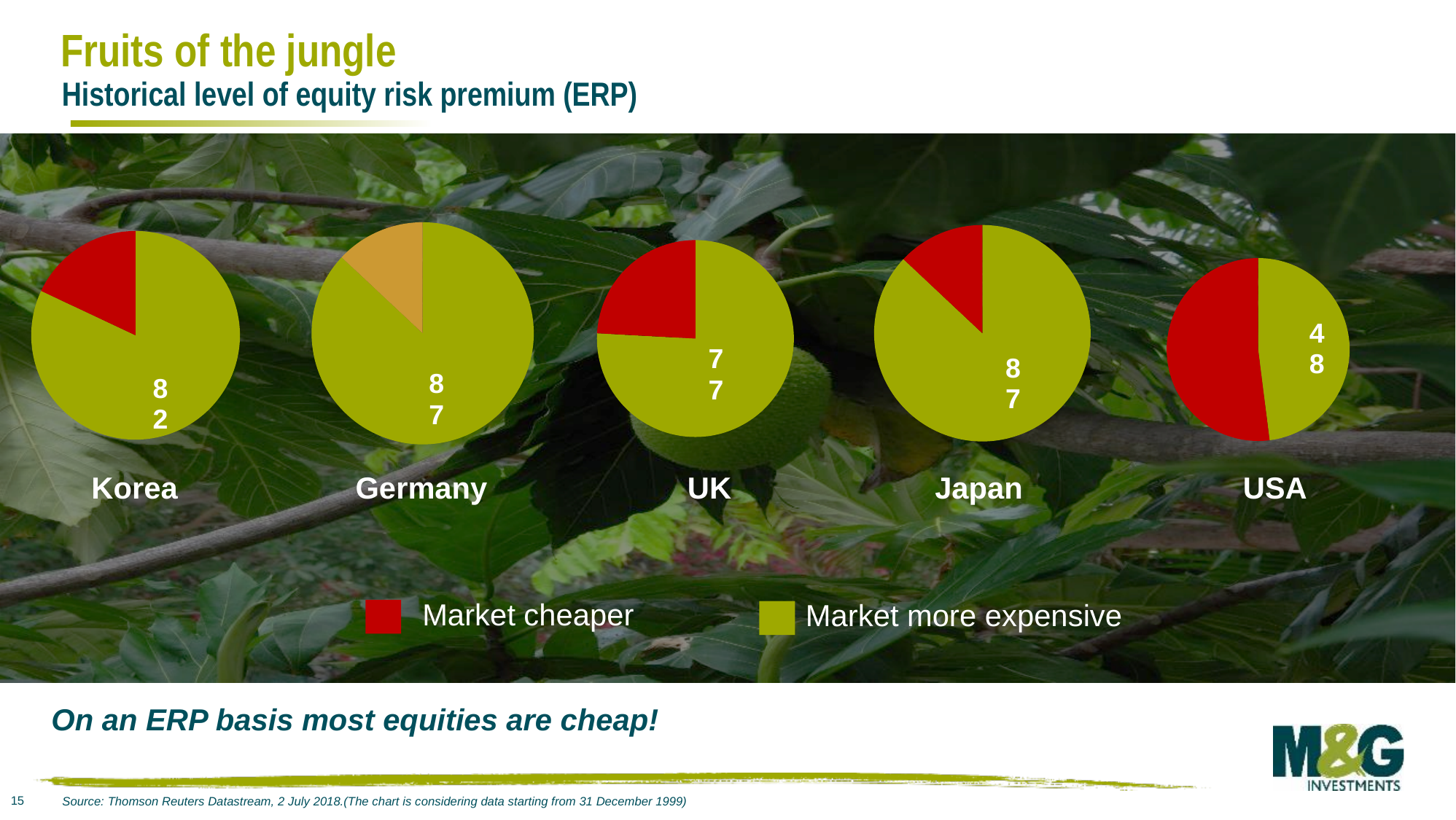
In the Japan pie chart, what value is printed on the 'Market more expensive' slice? 87 In the USA pie chart, what value is printed on the 'Market more expensive' slice? 48 Across the five pie charts, which country has the lowest printed 'Market more expensive' value? USA In the USA pie chart, which slice is larger, 'Market cheaper' or 'Market more expensive'? Market cheaper What is the difference between the printed value on the Germany pie chart and the printed value on the USA pie chart? 39 How many pie charts are shown on the slide? 5 What colour does the legend use for 'Market cheaper'? Red Which is larger, the printed value on the Korea pie chart or the printed value on the UK pie chart? Korea How many entries does the legend list? 2 In the Korea pie chart, what value is printed on the 'Market more expensive' slice? 82 In the Germany pie chart, what value is printed on the 'Market more expensive' slice? 87 In the UK pie chart, what value is printed on the 'Market more expensive' slice? 77